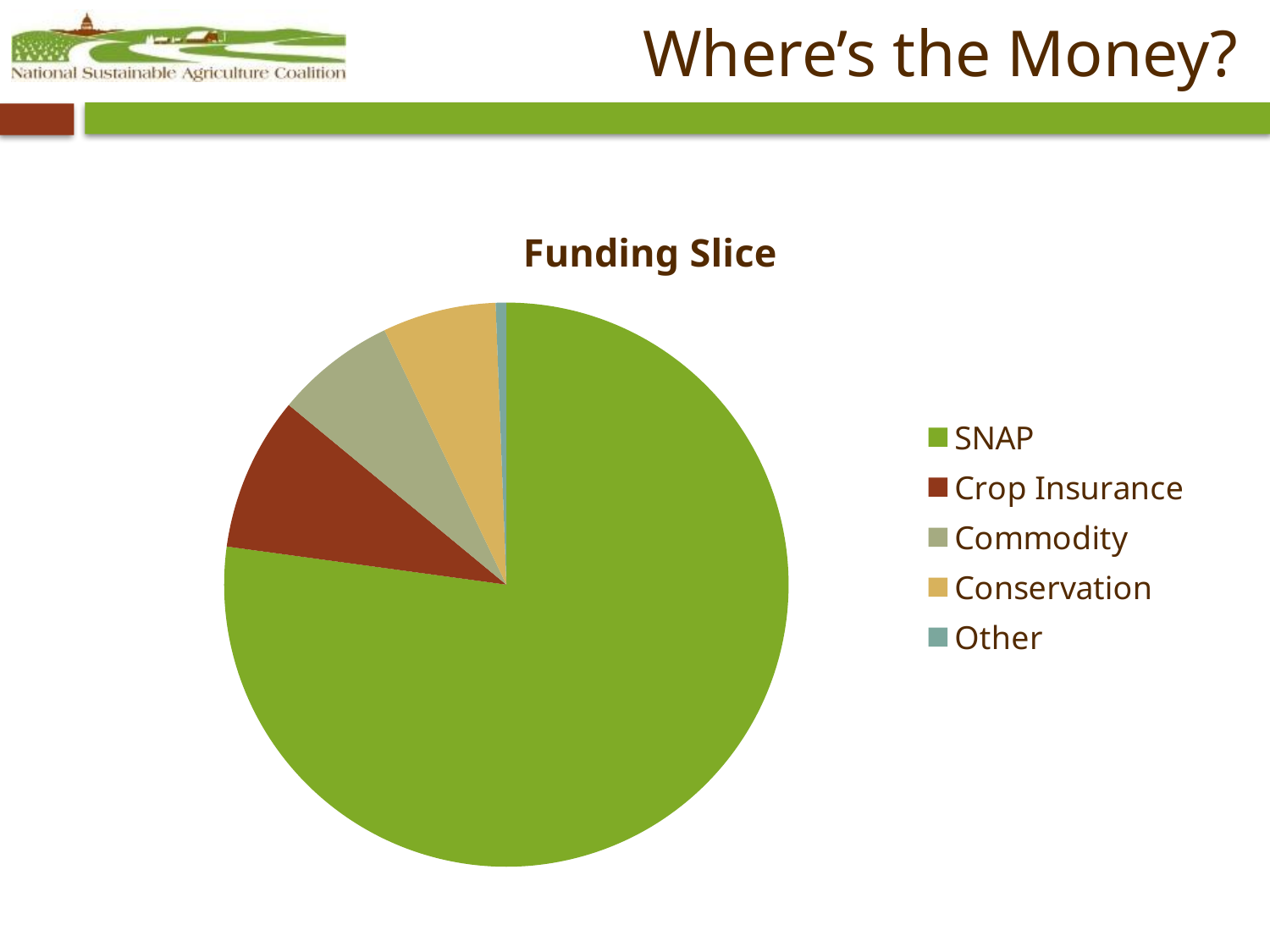
What is the title of the chart? Funding Slice Which category has the largest slice of the pie? SNAP Which category is shown in the dark red colour? Crop Insurance Which slice is larger, SNAP or Crop Insurance? SNAP What kind of chart is shown on the slide? Pie chart Which slice is larger, Crop Insurance or Commodity? Crop Insurance Which slice is larger, Crop Insurance or Other? Crop Insurance How many categories does the pie chart show? 5 Which category has the smallest slice of the pie? Other